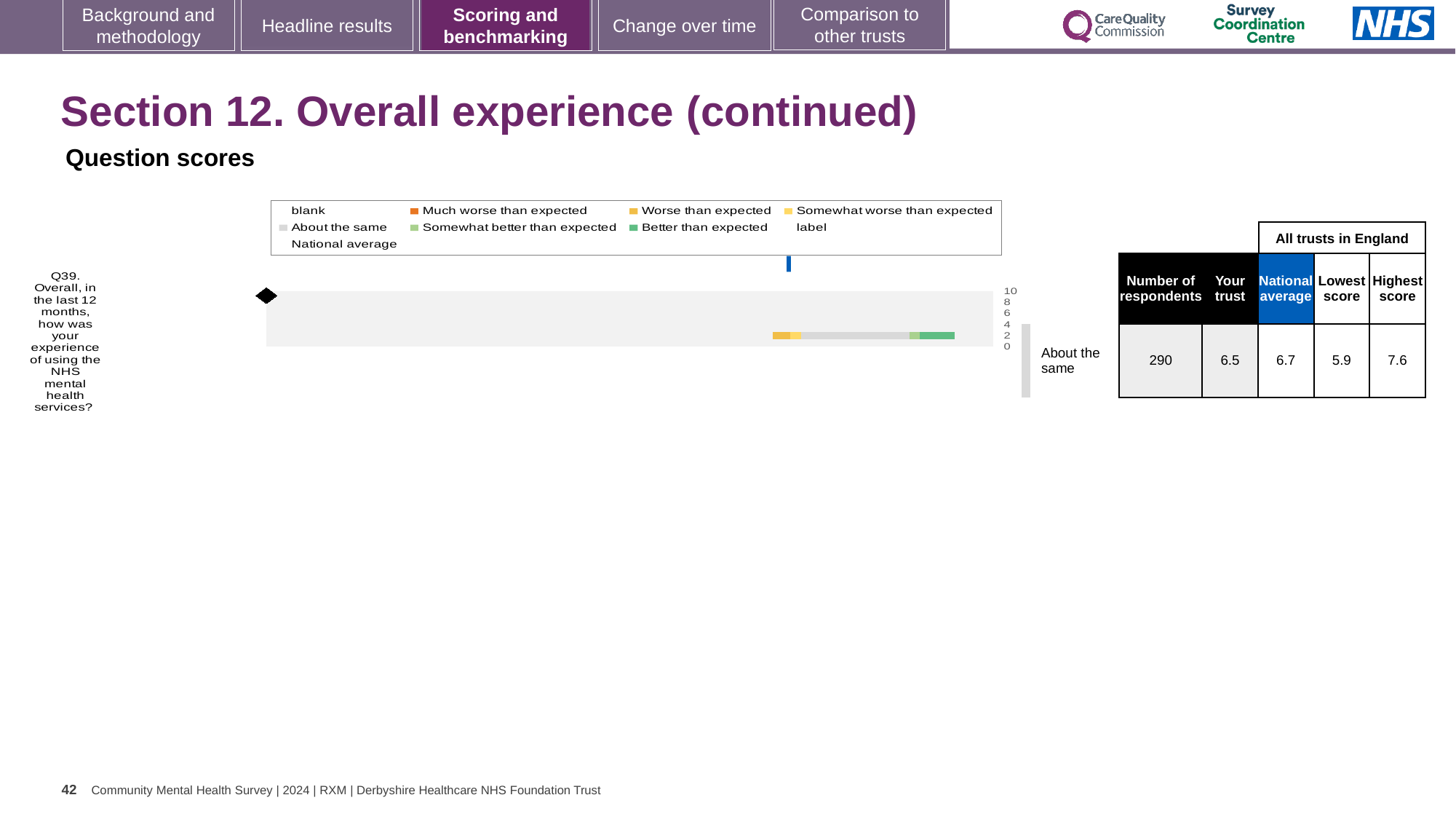
What is the highest score among all trusts in England for Q39? 7.6 What is the 'Your trust' score for Q39? 6.5 Which is larger for Q39, the 'Your trust' score or the national average? National average How many questions are plotted in the chart? 1 Which benchmark category is the trust's Q39 result placed in? About the same Which question number is plotted in the chart? Q39 How many respondents answered Q39? 290 What is the difference between the highest score and the lowest score for Q39? 1.7 What kind of chart is used to show the Q39 question score? bar chart What is the national average score for Q39? 6.7 What is the lowest score among all trusts in England for Q39? 5.9